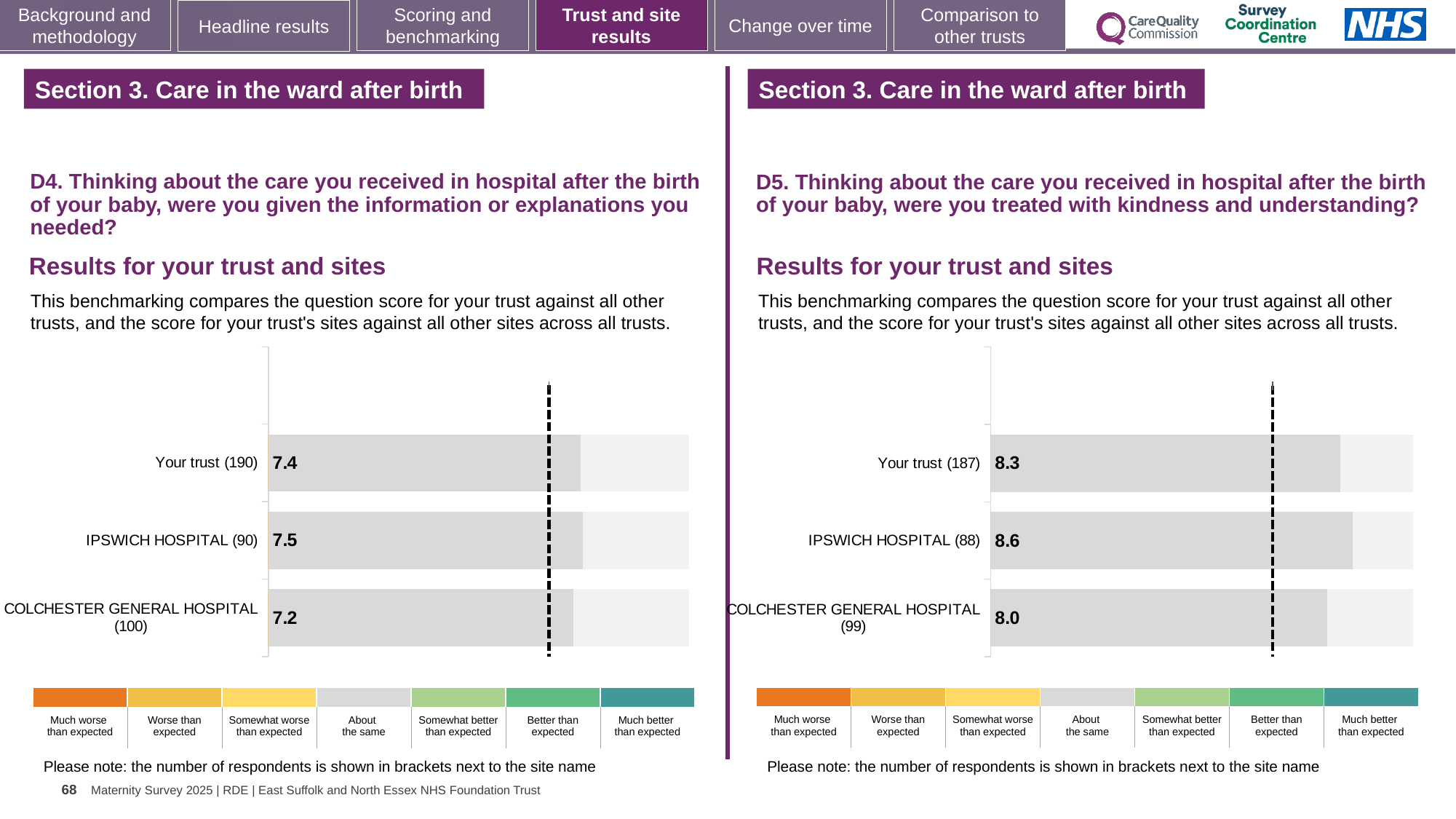
In the D4 chart on the left, what is the score for Your trust? 7.4 In the D5 chart on the right, what is the score for IPSWICH HOSPITAL? 8.6 In the D5 chart on the right, what is the score for COLCHESTER GENERAL HOSPITAL? 8.0 In the D4 chart on the left, what is the score for COLCHESTER GENERAL HOSPITAL? 7.2 In the D5 chart on the right, what is the difference between the scores for IPSWICH HOSPITAL and COLCHESTER GENERAL HOSPITAL? 0.6 In the D4 chart on the left, which has the larger score, Your trust or COLCHESTER GENERAL HOSPITAL? Your trust In the D4 chart on the left, how many respondents are shown in brackets for Your trust? 190 In the D4 chart on the left, what is the score for IPSWICH HOSPITAL? 7.5 In the D4 chart on the left, which site or trust has the highest score? IPSWICH HOSPITAL In the D5 chart on the right, what is the score for Your trust? 8.3 How many bars are shown in the D5 chart on the right? 3 In the D5 chart on the right, which site or trust has the lowest score? COLCHESTER GENERAL HOSPITAL